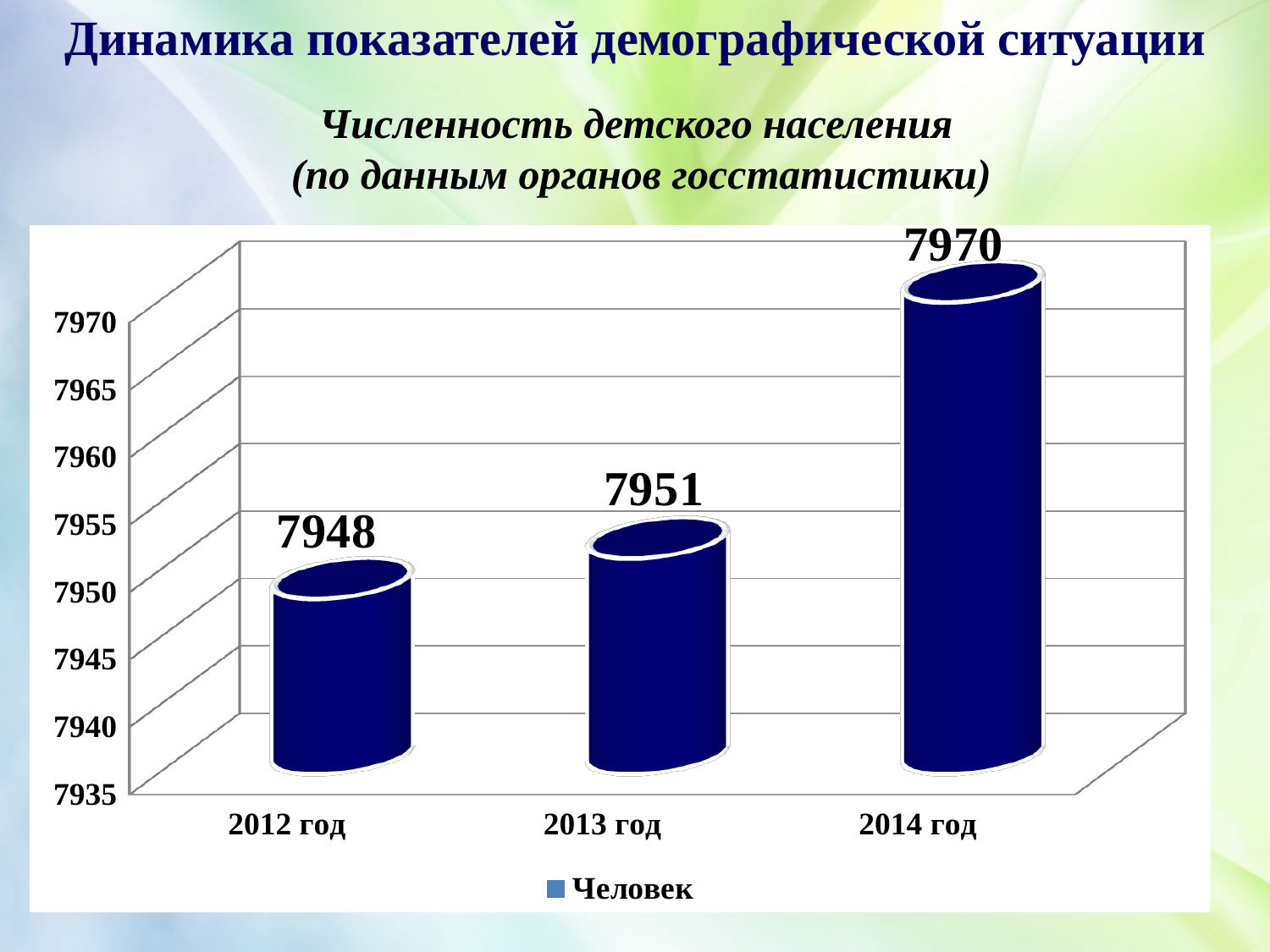
Which year has the highest value? 2014 год What kind of chart is shown? bar chart Which is larger, the value for 2013 год or the value for 2014 год? 2014 год What is the value for 2012 год? 7948 What is the difference between the values for 2013 год and 2012 год? 3 Which year has the lowest value? 2012 год What is the value for 2014 год? 7970 What is the value for 2013 год? 7951 How many years are shown on the chart? 3 Do the values rise or fall from 2012 год to 2014 год? rise How many series does the legend list? 1 What is the difference between the values for 2014 год and 2012 год? 22